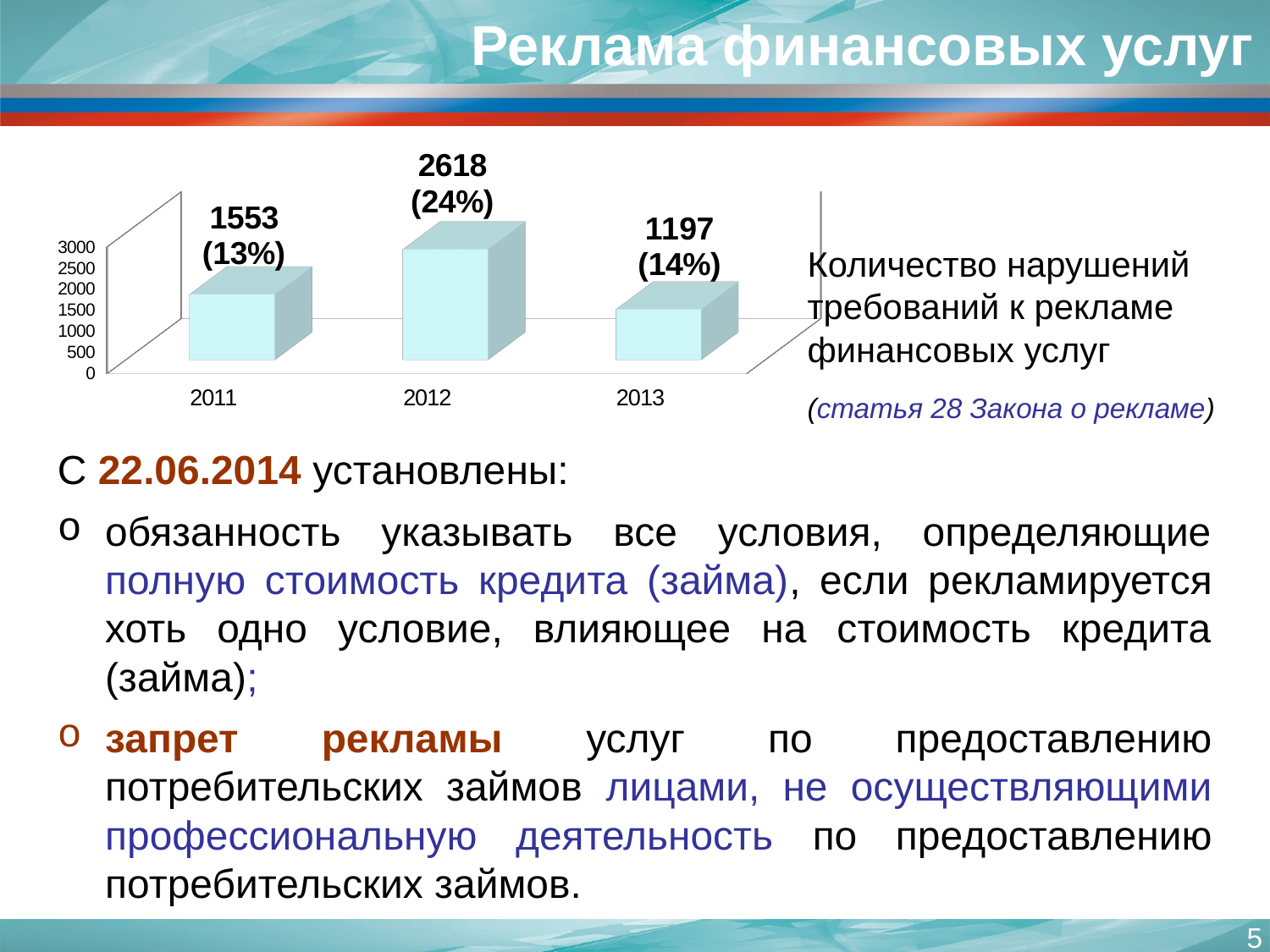
Which year has the lowest number of violations? 2013 Which is larger, the value for 2011 or the value for 2013? 2011 What is the value for 2011? 1553 (13%) What is the value for 2013? 1197 (14%) Is the value for 2012 greater or less than 2500? greater What is the difference between the values for 2011 and 2013? 356 How many years are shown on the x axis? 3 What is the value for 2012? 2618 (24%) What is the maximum value shown on the vertical axis? 3000 What kind of chart is shown on the slide? bar chart What is the difference between the values for 2012 and 2011? 1065 Which year has the highest number of violations? 2012